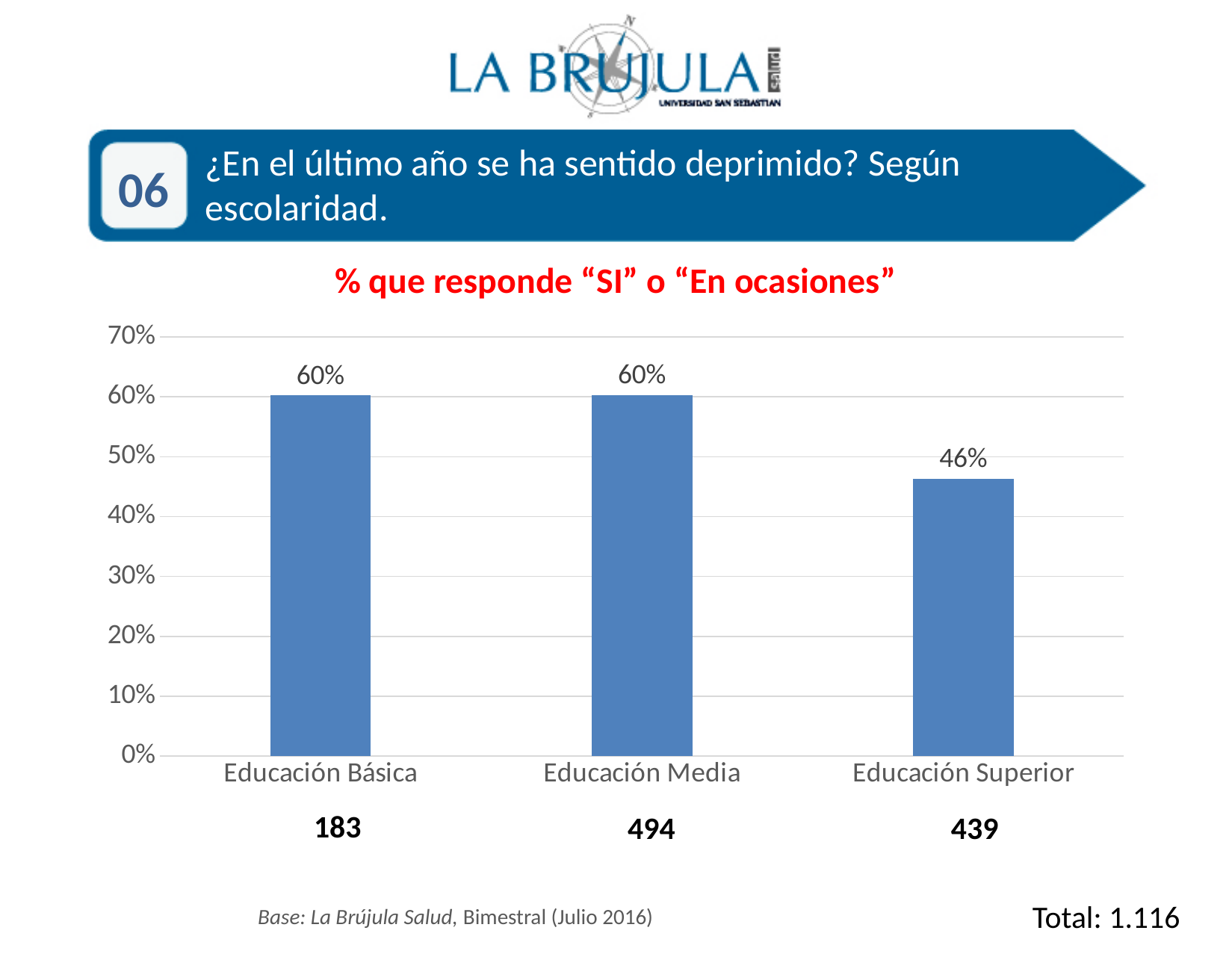
Is the value for Educación Superior greater or less than 50%? less What is the chart's title? % que responde "SI" o "En ocasiones" What is the value for Educación Superior? 46% What is the value for Educación Básica? 60% What is the base number shown below Educación Media? 494 What is the value for Educación Media? 60% Which category has the lowest value? Educación Superior What kind of chart is shown on the slide? bar chart How many categories are shown in the chart? 3 Which is larger, the value for Educación Básica or Educación Superior? Educación Básica What is the difference between the values for Educación Media and Educación Superior? 14% Is the value for Educación Básica greater or less than 50%? greater